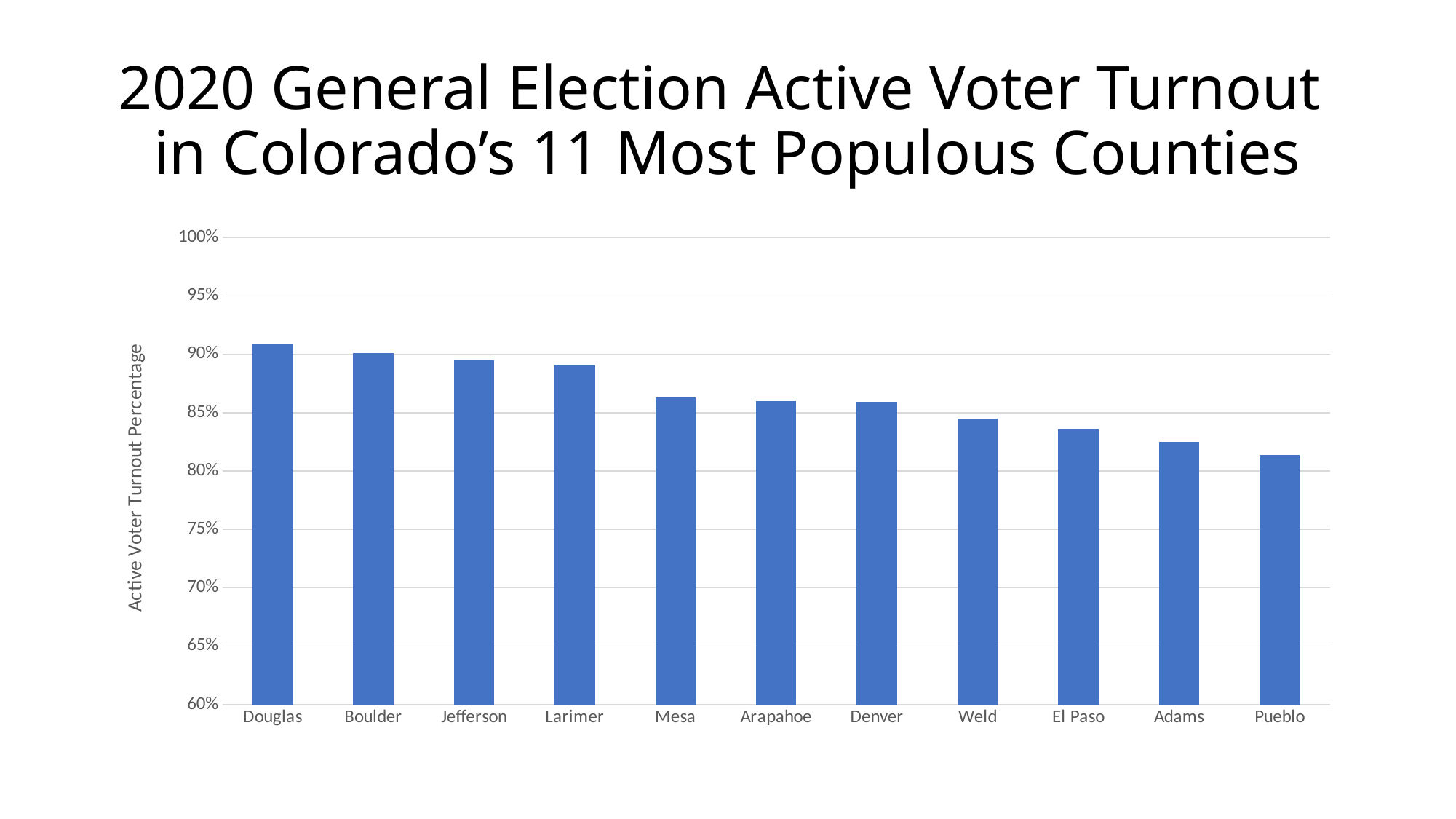
What is the label on the vertical axis of the chart? Active Voter Turnout Percentage Do the values rise or fall moving from left to right along the x axis? fall How many counties are shown on the x axis of the chart? 11 Is the value for Pueblo greater or less than 85%? less Is the value for Larimer greater or less than 90%? less Which has a higher active voter turnout percentage, Boulder or Mesa? Boulder Which county has the lowest active voter turnout percentage? Pueblo Which county has the highest active voter turnout percentage? Douglas What kind of chart is shown on the slide? bar chart Is the value for El Paso greater or less than 85%? less